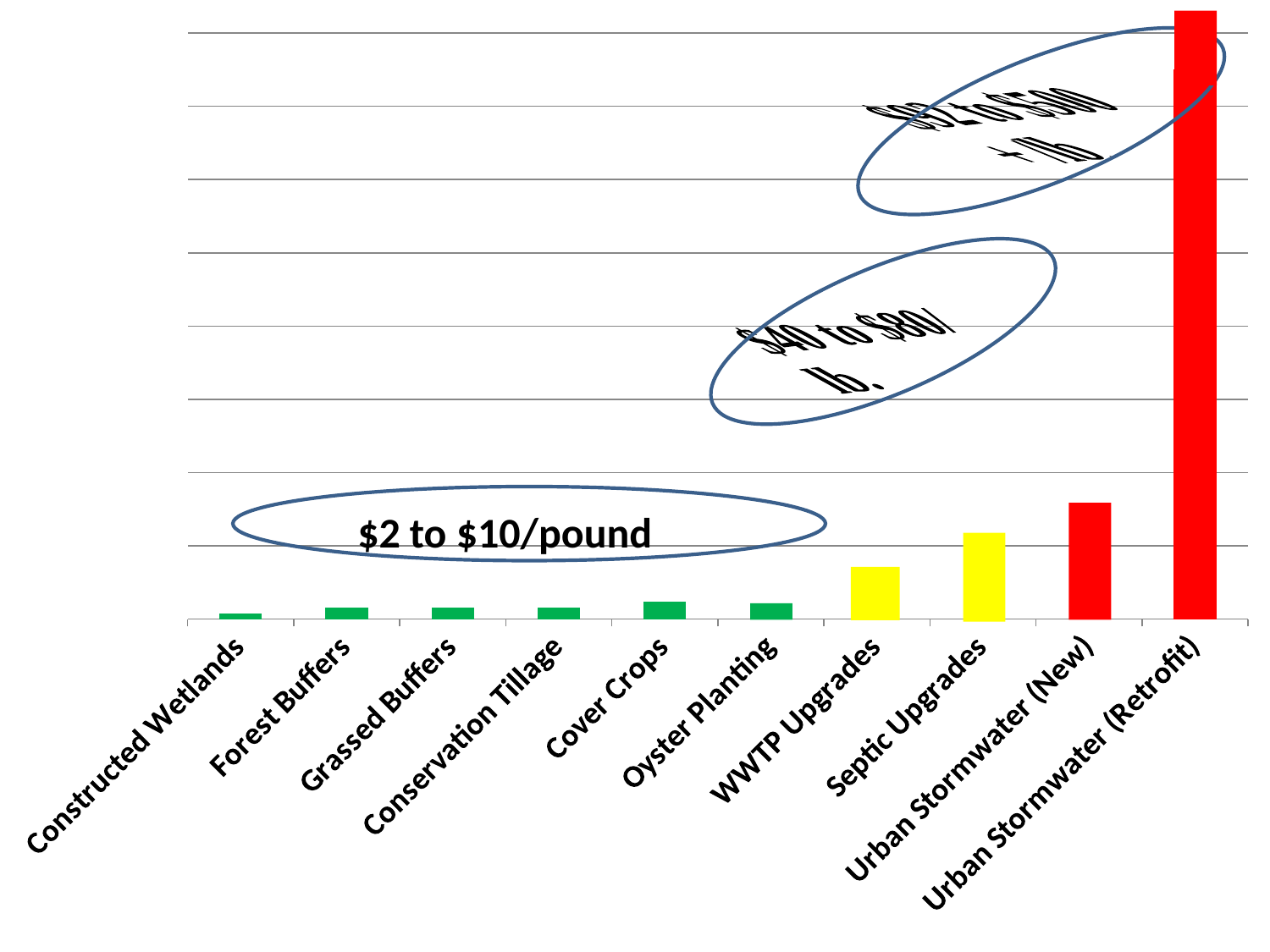
Which category has the lowest bar? Constructed Wetlands What kind of chart is shown on the slide? bar chart Which is larger, the bar for Cover Crops or the bar for Constructed Wetlands? Cover Crops Which is larger, the bar for Urban Stormwater (New) or the bar for Septic Upgrades? Urban Stormwater (New) Do the bar values generally rise or fall from left to right along the x axis? rise Which is larger, the bar for WWTP Upgrades or the bar for Septic Upgrades? Septic Upgrades Which category has the highest bar? Urban Stormwater (Retrofit) How many categories are shown on the x axis of the chart? 10 What cost range is written in the oval above the green bars? $2 to $10/pound How many bars are coloured green? 6